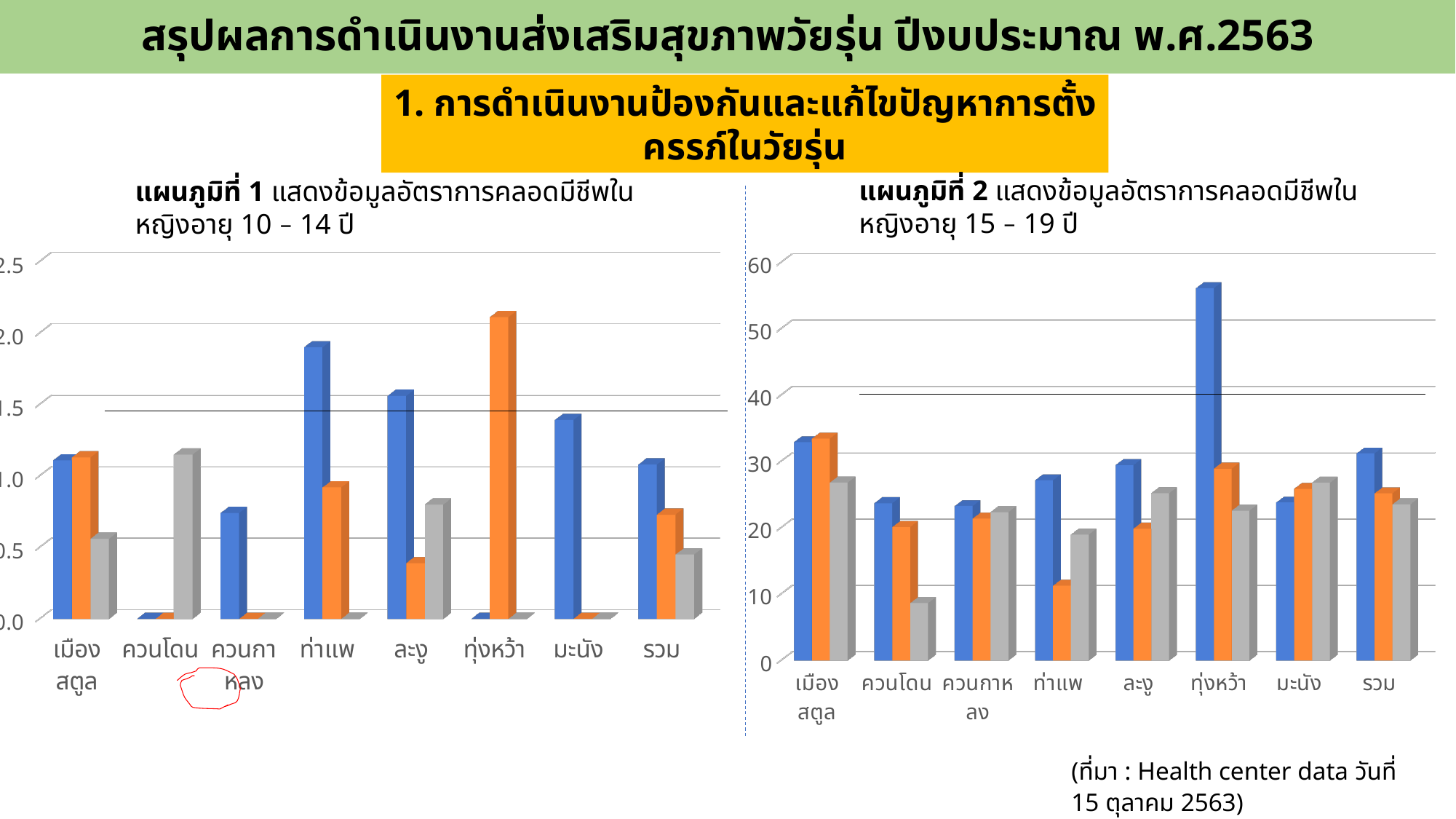
In แผนภูมิที่ 2 (the right chart), which category has the shortest gray bar? ควนโดน What is the title of the right chart? แผนภูมิที่ 2 แสดงข้อมูลอัตราการคลอดมีชีพในหญิงอายุ 15 – 19 ปี In แผนภูมิที่ 1 (the left chart), which category has the tallest blue bar? ท่าแพ In แผนภูมิที่ 1 (the left chart), is the blue bar for ท่าแพ greater or less than 1.5? greater In แผนภูมิที่ 1 (the left chart), is the blue bar for ควนกาหลง greater or less than 1.0? less In แผนภูมิที่ 1 (the left chart), which is larger, the blue bar for ท่าแพ or the blue bar for ละงู? ท่าแพ In แผนภูมิที่ 2 (the right chart), which category has the tallest blue bar? ทุ่งหว้า In แผนภูมิที่ 2 (the right chart), is the orange bar for ท่าแพ greater or less than 20? less How many categories are shown on the x axis of แผนภูมิที่ 2 (the right chart)? 8 What kind of chart is แผนภูมิที่ 1 (the left chart)? bar chart